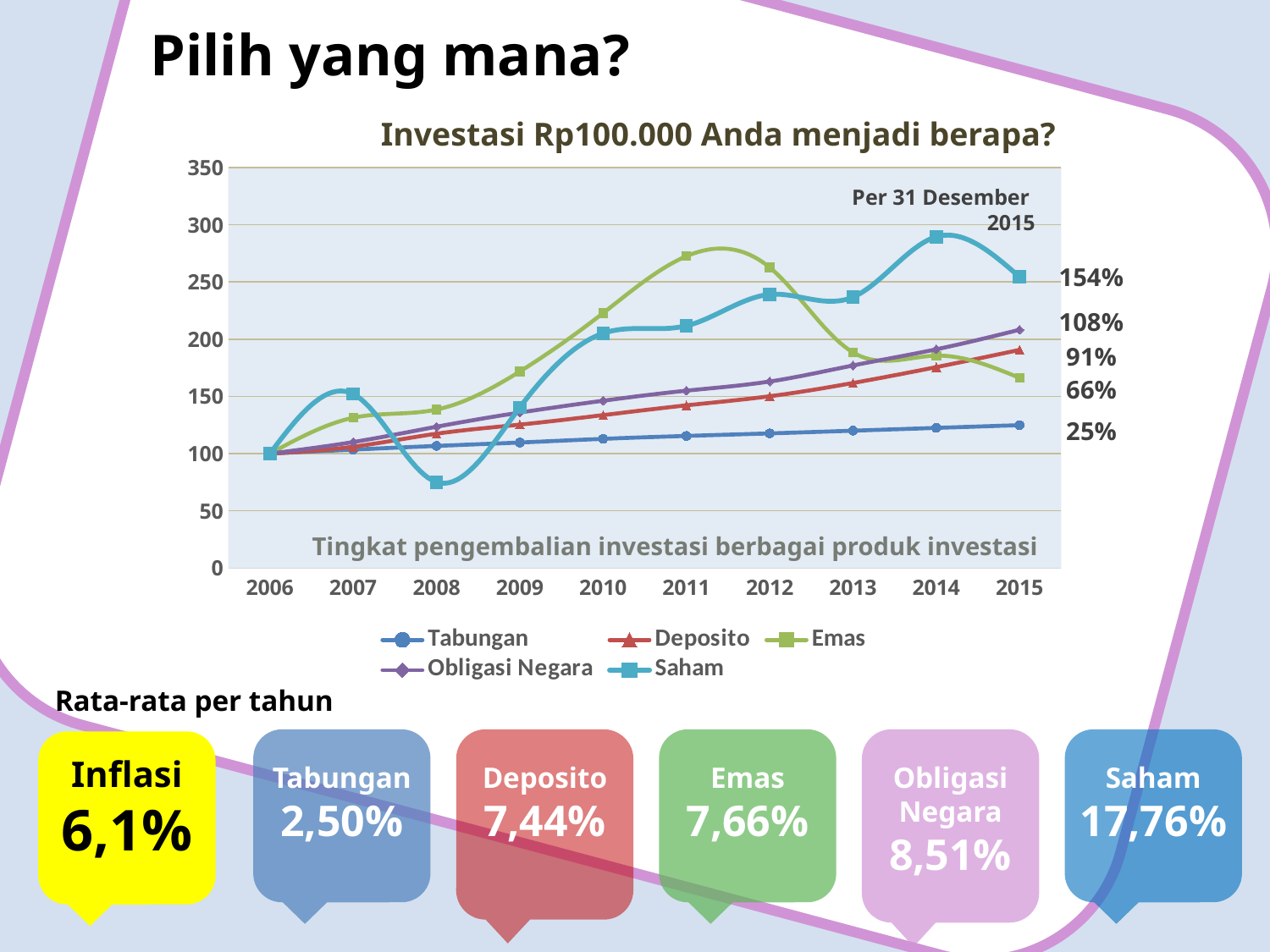
How many series does the chart legend list? 5 What is the title of the chart? Investasi Rp100.000 Anda menjadi berapa? How many years are plotted along the x axis of the chart? 10 Which series has the lowest value in 2015? Tabungan Is the value for Emas in 2011 greater or less than 250? greater Does the Tabungan line rise or fall from 2006 to 2015? rise Is the value for Saham in 2008 greater or less than 100? less In 2012, which is higher: Emas or Saham? Emas What kind of chart is shown on the slide? line chart Which series has the highest value in 2015? Saham What value do all the series start at in 2006? 100 Is the value for Saham in 2014 greater or less than 250? greater